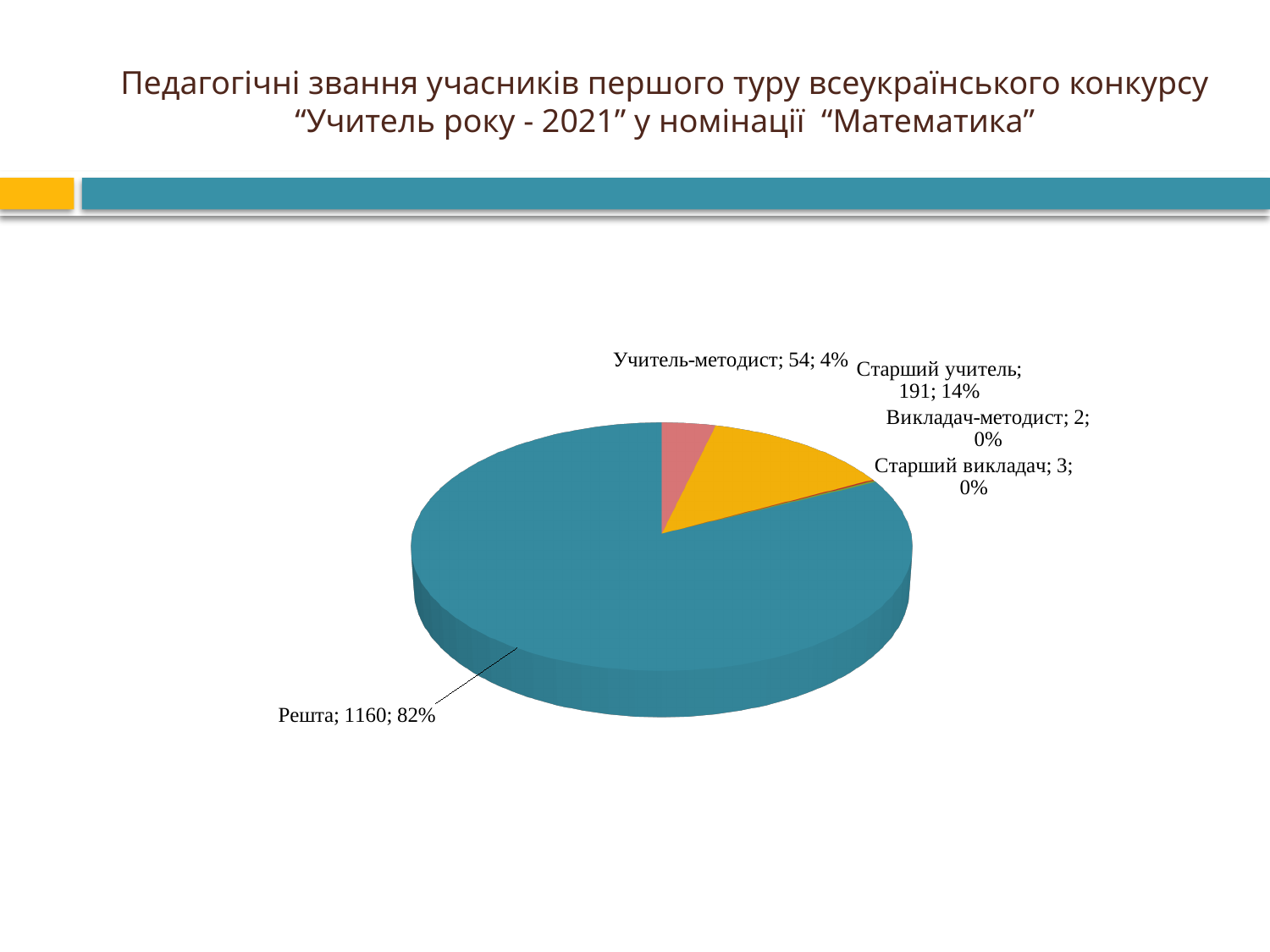
Which category has the largest slice? Решта What kind of chart is shown on the slide? pie chart What is the difference between the values for Старший учитель and Учитель-методист? 137 What is the value for Викладач-методист? 2 What is the value for Решта? 1160 What share of the pie does Старший учитель take? 14% What is the value for Учитель-методист? 54 What share of the pie does Решта take? 82% Which is larger, the value for Старший викладач or the value for Викладач-методист? Старший викладач Which category has the smallest value? Викладач-методист What is the value for Старший учитель? 191 How many categories does the pie chart show? 5